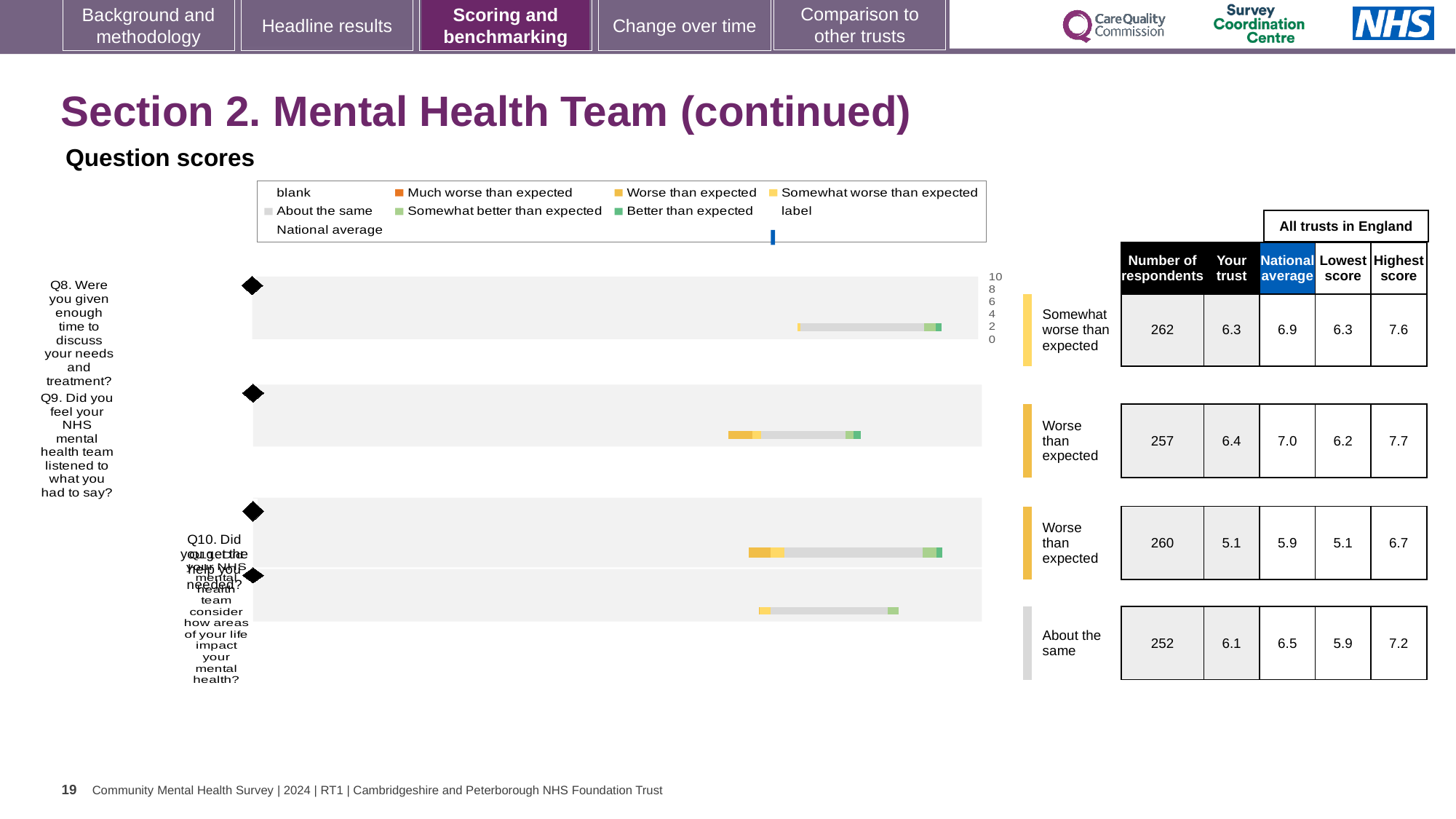
How many question bars are plotted in the question scores chart? 4 Which question has the lowest 'Your trust' score? Q10 Which question has the highest number of respondents? Q8 What kind of chart is used to show the question scores on this slide? bar chart For Q8, which is larger: the 'Your trust' score or the national average? national average What is the heading shown above the question scores chart? Question scores What is the national average score for Q9 (Did you feel your NHS mental health team listened to what you had to say?)? 7.0 What is the highest score among all trusts in England for Q10? 6.7 What is the difference between the highest score and the lowest score for Q9? 1.5 How many respondents answered Q10 (Did you get the help you needed?)? 260 In the chart legend, what colour represents 'About the same'? grey What is the 'Your trust' score for Q8 (Were you given enough time to discuss your needs and treatment?)? 6.3